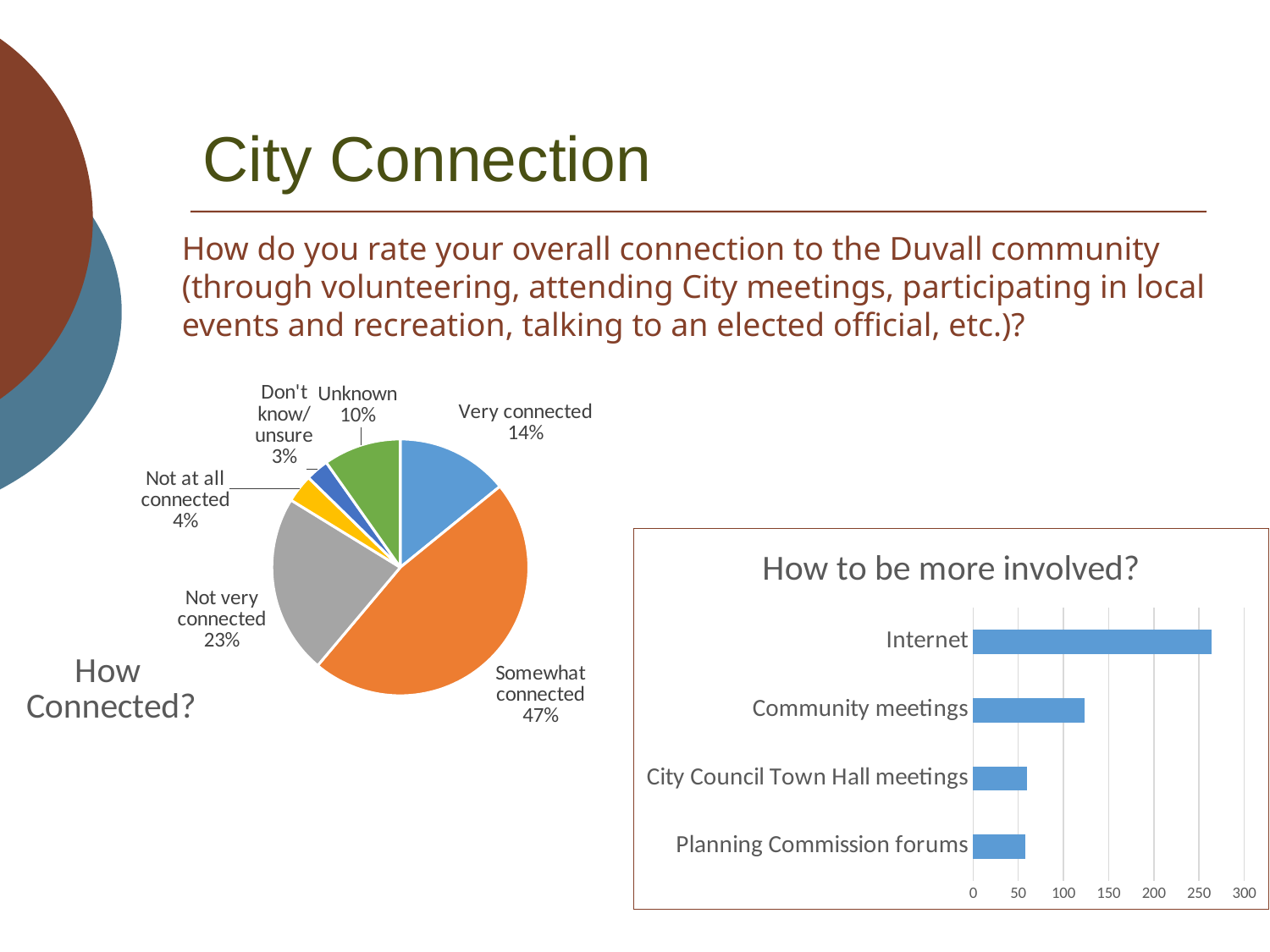
In the "How Connected?" pie chart, which category has the largest share? Somewhat connected How many categories are shown in the "How to be more involved?" chart? 4 What kind of chart is "How to be more involved?"? Bar chart In the "How Connected?" pie chart, what is the difference in percentage points between Somewhat connected and Not very connected? 24 In the "How Connected?" pie chart, which is larger: Unknown or Not at all connected? Unknown In the "How to be more involved?" chart, is the value for Internet greater or less than 250? greater How many slices does the "How Connected?" pie chart have? 6 In the "How Connected?" pie chart, what share of respondents are somewhat connected? 47% In the "How to be more involved?" chart, is the value for Community meetings greater or less than 100? greater In the "How to be more involved?" chart, which category has the highest value? Internet In the "How Connected?" pie chart, what share of respondents are very connected? 14% In the "How Connected?" pie chart, which category has the smallest share? Don't know/unsure